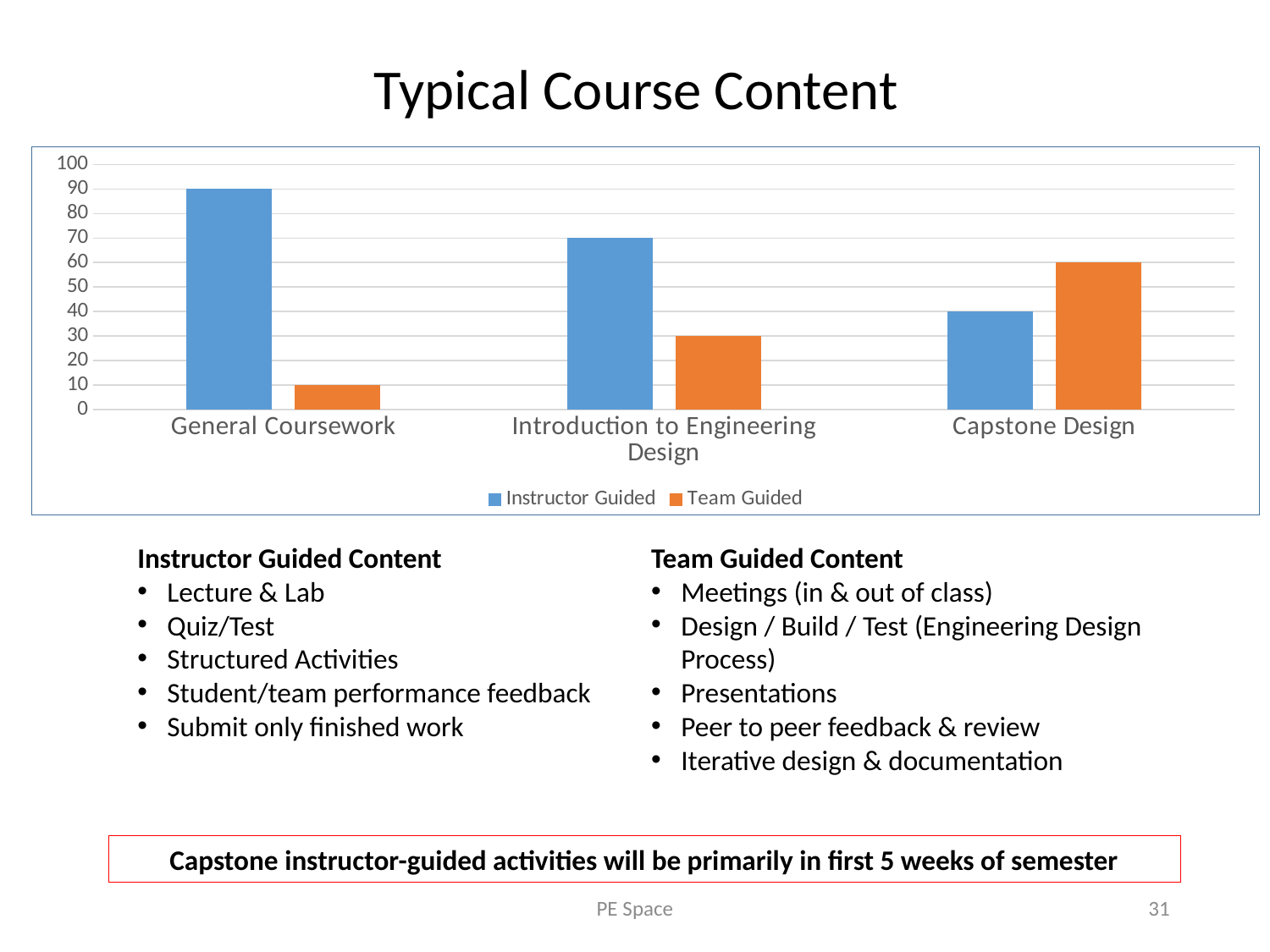
Which category has the highest Instructor Guided value? General Coursework What is the difference between the Instructor Guided and Team Guided values for Capstone Design? 20 Which category has the lowest Team Guided value? General Coursework How many categories are shown on the x axis? 3 Which colour represents the Team Guided series? orange Which is larger for Introduction to Engineering Design, Instructor Guided or Team Guided? Instructor Guided How many series does the legend list? 2 What kind of chart is shown on the slide? bar chart What is the Instructor Guided value for General Coursework? 90 What is the Team Guided value for Capstone Design? 60 What is the Team Guided value for Introduction to Engineering Design? 30 Do the Team Guided values rise or fall from General Coursework to Capstone Design? rise